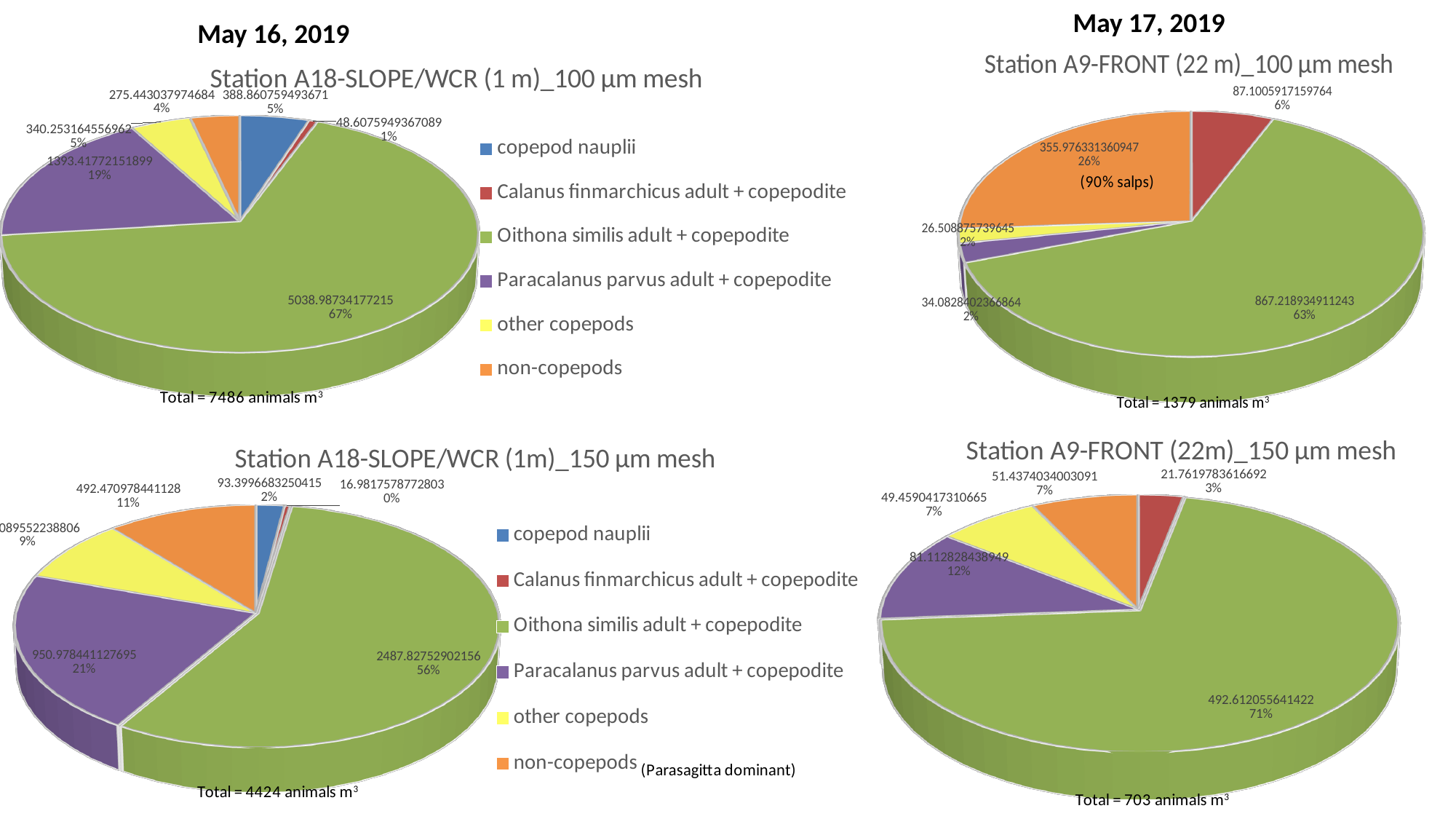
In the Station A9-FRONT (22 m)_100 µm mesh chart, which category has the largest slice? Oithona similis adult + copepodite In the Station A18-SLOPE/WCR (1m)_150 µm mesh chart, what percentage share does Paracalanus parvus adult + copepodite have? 21% In the Station A9-FRONT (22 m)_100 µm mesh chart, what percentage share do non-copepods have? 26% In the Station A9-FRONT (22m)_150 µm mesh chart, what is the value labelled for Oithona similis adult + copepodite? 492.612055641422 How many categories does the legend next to the Station A18-SLOPE/WCR (1 m)_100 µm mesh chart list? 6 In the Station A9-FRONT (22m)_150 µm mesh chart, which is larger: the Paracalanus parvus slice or the Calanus finmarchicus slice? Paracalanus parvus adult + copepodite In the Station A18-SLOPE/WCR (1m)_150 µm mesh chart, which category has the smallest slice? Calanus finmarchicus adult + copepodite In the Station A18-SLOPE/WCR (1 m)_100 µm mesh chart, what is the value labelled for Paracalanus parvus adult + copepodite? 1393.41772151899 In the Station A18-SLOPE/WCR (1 m)_100 µm mesh chart, what percentage share does Oithona similis adult + copepodite have? 67% What kind of chart is used for Station A9-FRONT (22 m)_100 µm mesh? Pie chart What total is stated below the Station A18-SLOPE/WCR (1 m)_100 µm mesh chart? Total = 7486 animals m³ What total is stated below the Station A9-FRONT (22m)_150 µm mesh chart? Total = 703 animals m³